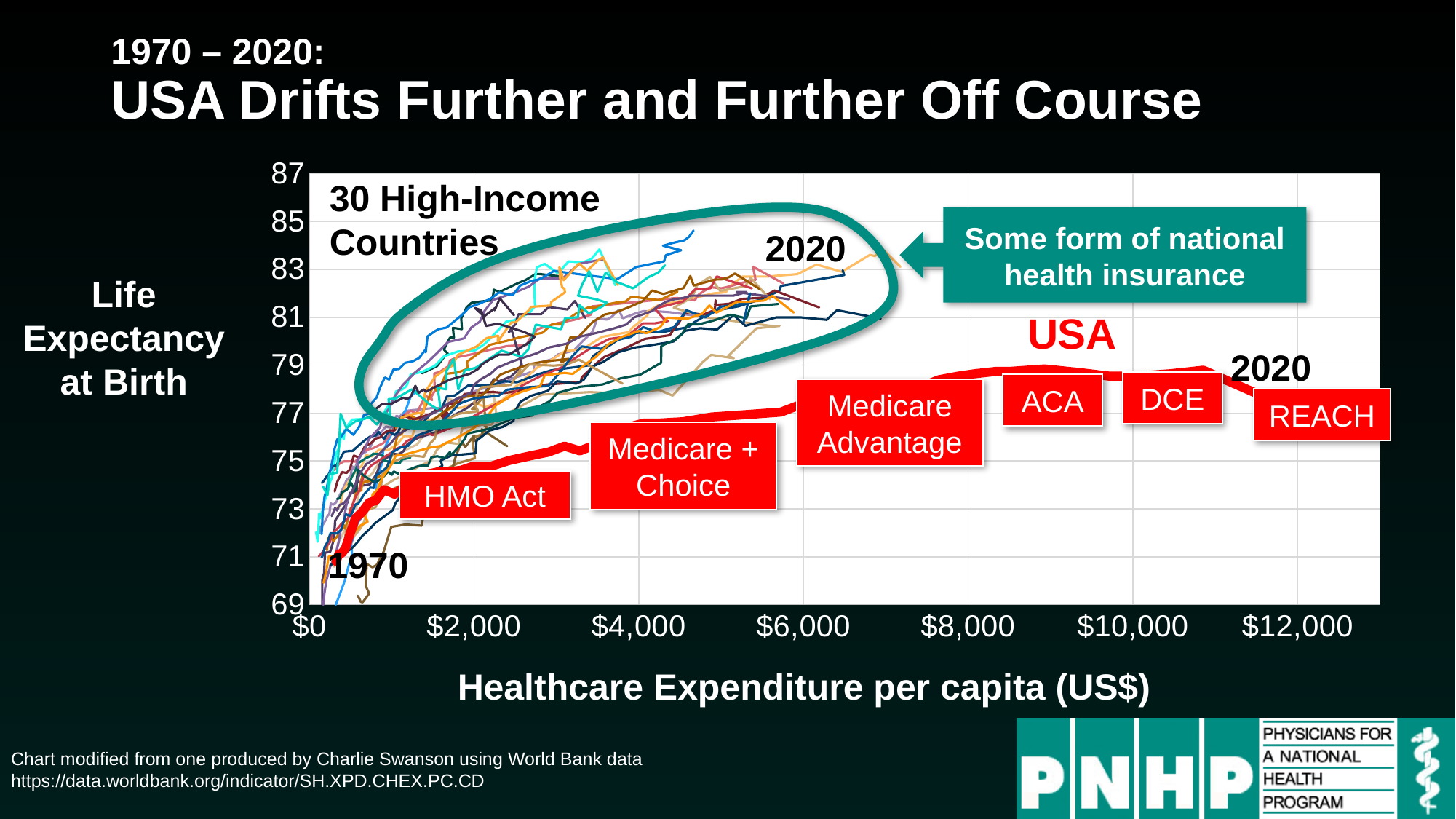
What kind of chart is shown on the slide? line chart In 2020, which has the higher healthcare expenditure per capita: the USA or the 30 high-income countries? USA How many high-income countries does the chart say are plotted alongside the USA? 30 How many US policy labels (red boxes) are placed along the USA line? 6 Is the USA's life expectancy at birth in 2020 greater or less than 79? less Is the USA's healthcare expenditure per capita in 2020 greater or less than $10,000? greater Does the USA line rise or fall at its far right end, after the DCE label? fall In 2020, which has the higher life expectancy at birth: the USA or the 30 high-income countries? the 30 high-income countries What is the label of the y axis of the chart? Life Expectancy at Birth What is the label of the x axis of the chart? Healthcare Expenditure per capita (US$) Is the healthcare expenditure per capita of the 30 high-income countries in 2020 greater or less than $8,000? less What is the highest value shown on the y axis of the chart? 87